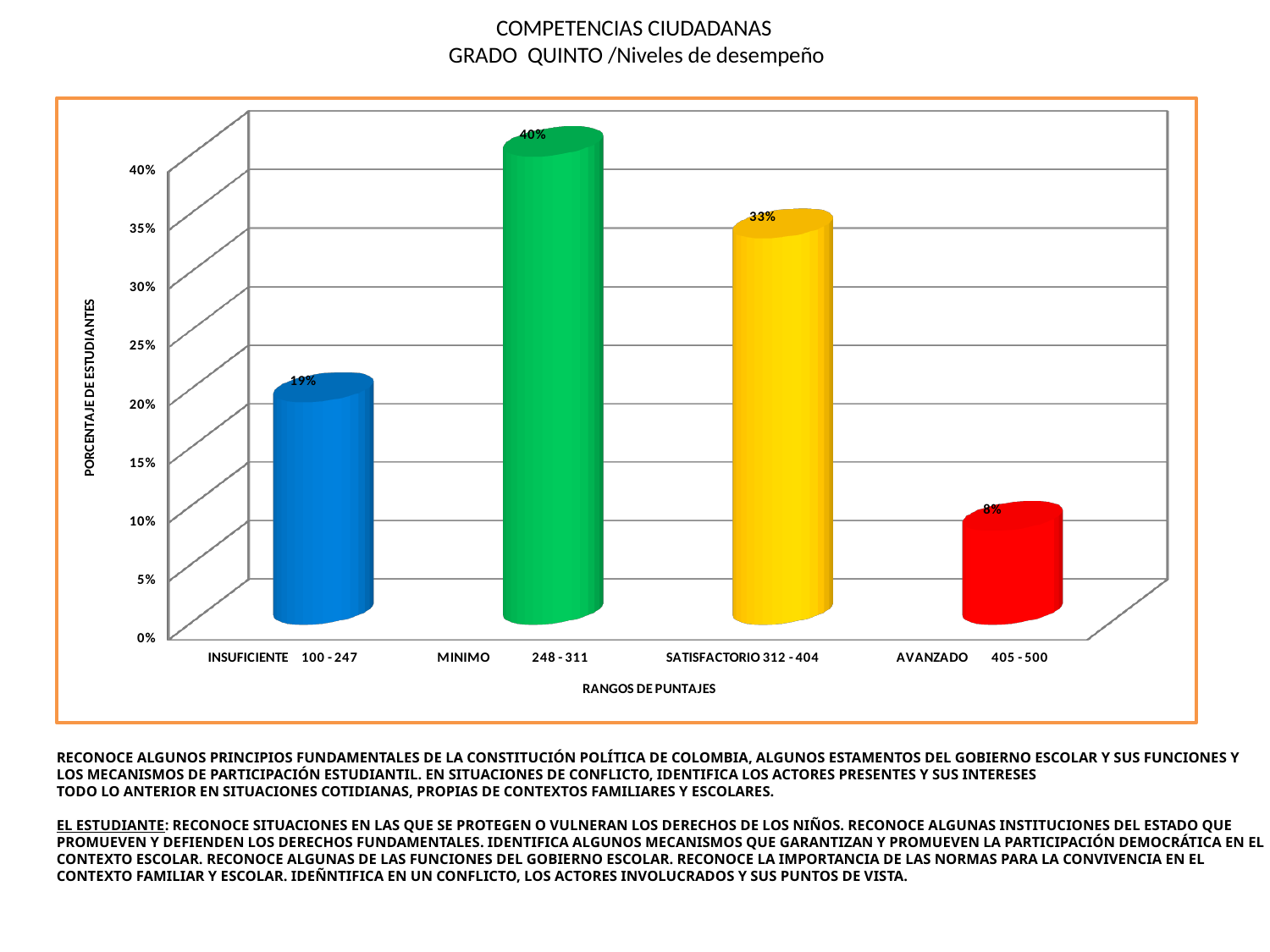
How many performance levels are plotted on the chart? 4 What percentage of students is shown for the AVANZADO 405 - 500 level? 8% What percentage of students is shown for the INSUFICIENTE 100 - 247 level? 19% What is the label of the vertical axis of the chart? PORCENTAJE DE ESTUDIANTES What percentage of students is shown for the MINIMO 248 - 311 level? 40% What is the difference in percentage points between the MINIMO and SATISFACTORIO levels? 7% Which performance level has the highest percentage of students? MINIMO 248 - 311 What percentage of students is shown for the SATISFACTORIO 312 - 404 level? 33% Which performance level has the lowest percentage of students? AVANZADO 405 - 500 What kind of chart is shown on the slide? Bar chart What is the difference in percentage points between the INSUFICIENTE and AVANZADO levels? 11% Which has a larger percentage of students, INSUFICIENTE or SATISFACTORIO? SATISFACTORIO